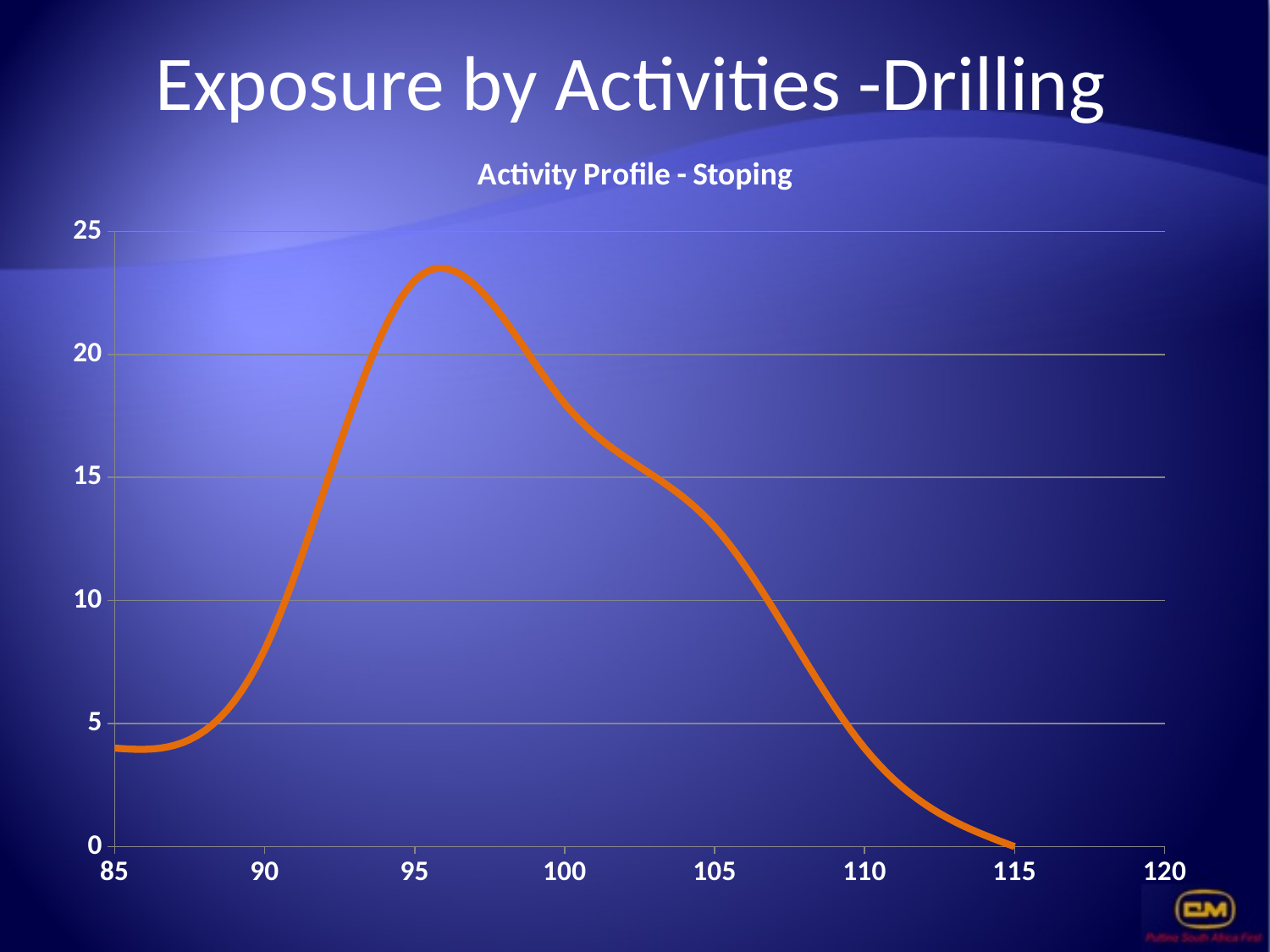
Is the value of the line at 90 greater or less than 5? greater What is the highest value shown on the y axis? 25 What is the title of the chart? Activity Profile - Stoping Is the peak value of the line greater or less than 20? greater Is the value of the line at 85 greater or less than 5? less Does the line rise or fall between 100 and 115 on the x axis? fall What kind of chart is shown on the slide? line chart Does the line rise or fall between 85 and 95 on the x axis? rise